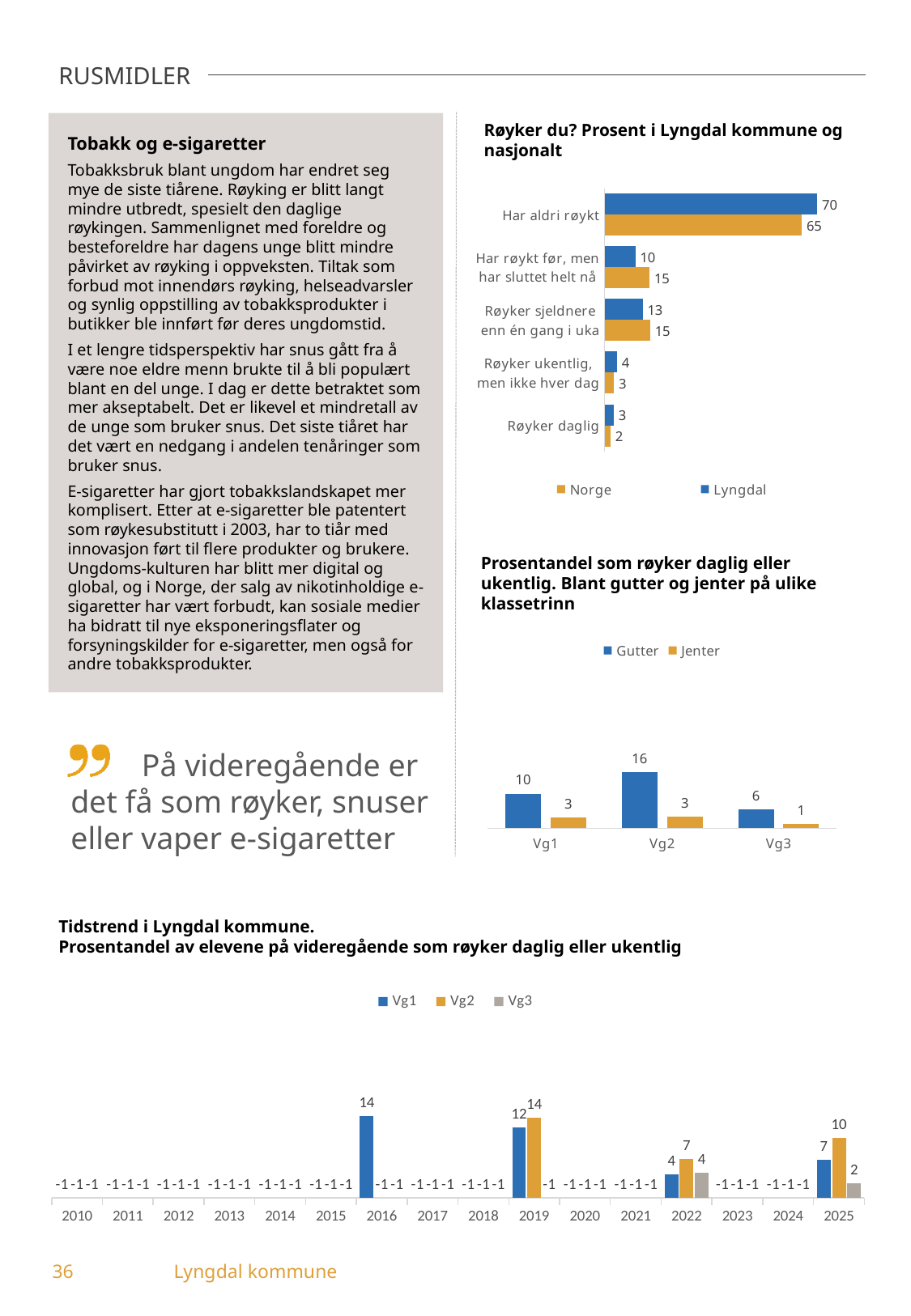
In the chart 'Røyker du? Prosent i Lyngdal kommune og nasjonalt', which category has the lowest Norge value? Røyker daglig In the chart 'Røyker du? Prosent i Lyngdal kommune og nasjonalt', what is the Norge value for 'Har røykt før, men har sluttet helt nå'? 15 How many series does the legend of the chart 'Tidstrend i Lyngdal kommune' list? 3 In the chart 'Prosentandel som røyker daglig eller ukentlig', is the Gutter value for Vg1 larger or smaller than the Jenter value for Vg1? Larger What type of chart is 'Røyker du? Prosent i Lyngdal kommune og nasjonalt'? Bar chart In the chart 'Røyker du? Prosent i Lyngdal kommune og nasjonalt', what is the difference between the Lyngdal and Norge values for 'Har aldri røykt'? 5 In the chart 'Prosentandel som røyker daglig eller ukentlig', what is the Gutter value for Vg2? 16 In the chart 'Røyker du? Prosent i Lyngdal kommune og nasjonalt', what is the Lyngdal value for 'Har aldri røykt'? 70 In the chart 'Tidstrend i Lyngdal kommune', what is the difference between the Vg2 and Vg1 values for 2019? 2 In the chart 'Røyker du? Prosent i Lyngdal kommune og nasjonalt', how many categories are shown? 5 In the chart 'Tidstrend i Lyngdal kommune', what is the Vg2 value for 2025? 10 In the chart 'Prosentandel som røyker daglig eller ukentlig', which class level has the lowest Jenter value? Vg3